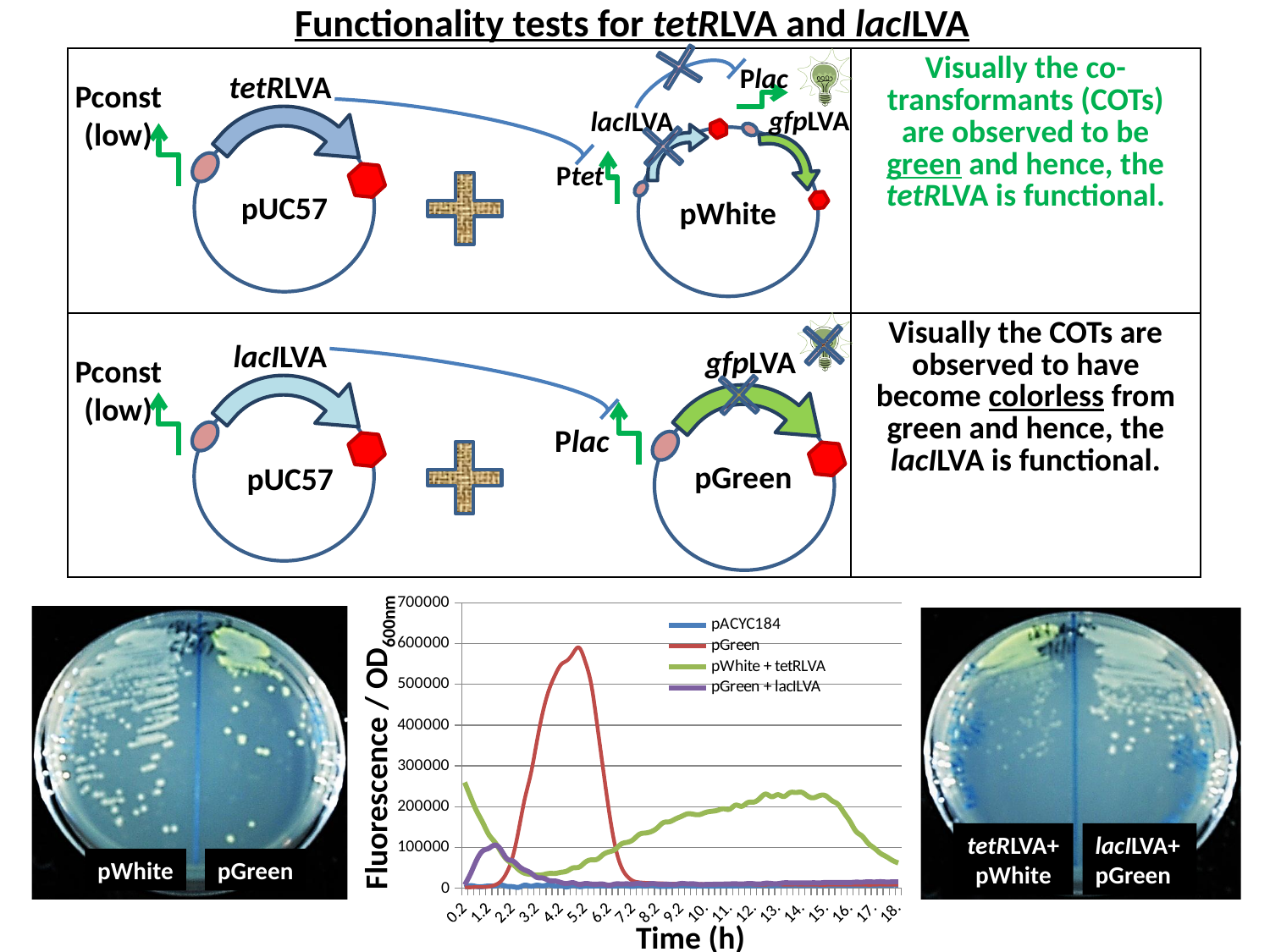
Is the peak value of the pWhite + tetRLVA series greater or less than 200000? greater Which series has a higher peak value: pGreen or pWhite + tetRLVA? pGreen Does the pGreen series rise or fall between 6.2 h and 7.2 h? fall What kind of chart is shown at the bottom of the slide? line chart What is the label of the x axis of the line chart? Time (h) Is the peak value of the pWhite + tetRLVA series greater or less than 300000? less Is the value of the pACYC184 series at any time greater or less than 100000? less Which series in the line chart reaches the highest fluorescence / OD value? pGreen How many series does the legend of the line chart list? 4 Which series in the line chart is drawn in red? pGreen Which series has a higher peak value: pGreen + lacILVA or pACYC184? pGreen + lacILVA